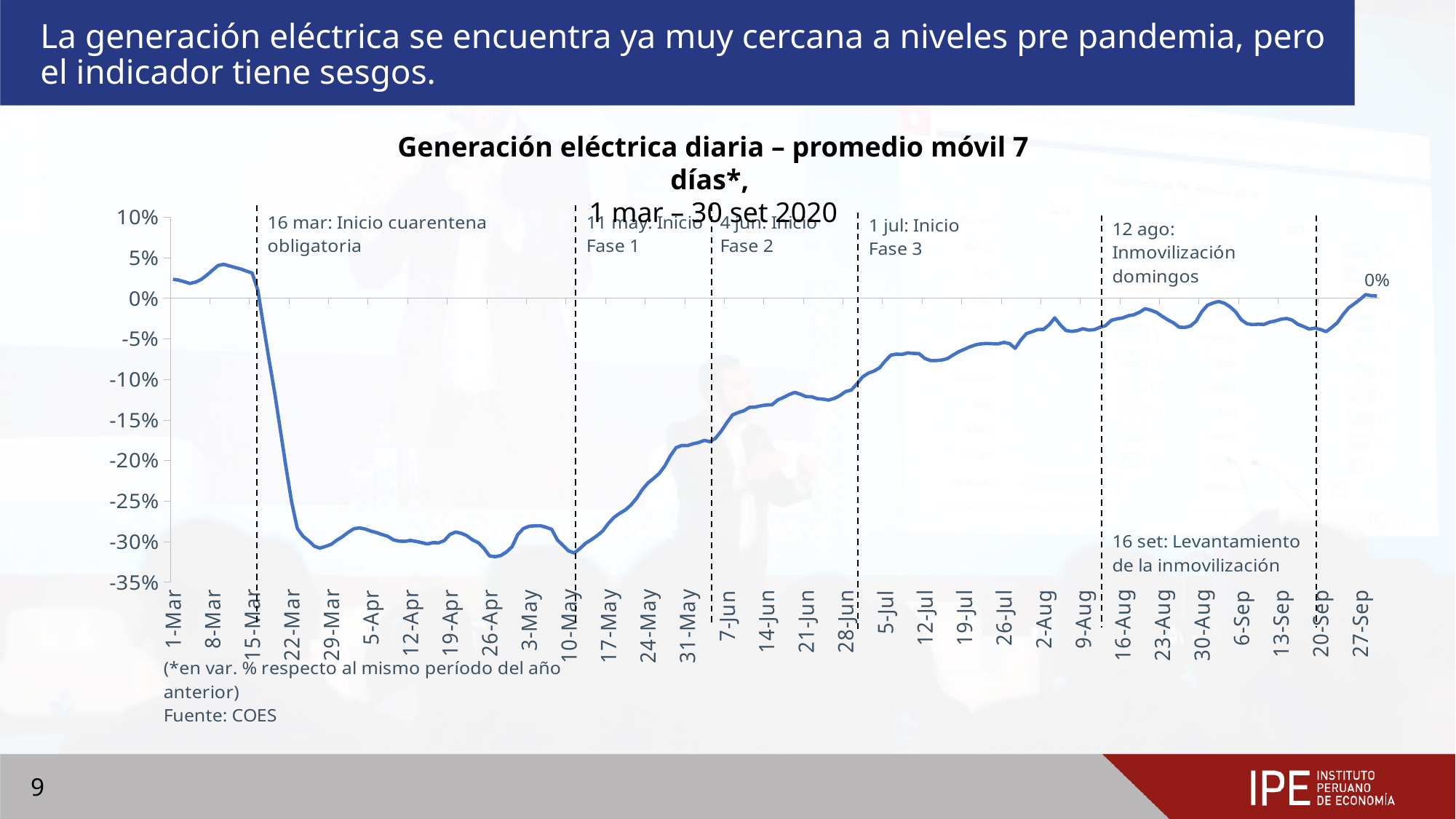
Is the value for 31-May greater or less than -15%? less Is the value for 5-Jul greater or less than -10%? greater Does the line rise or fall between 10-May and 28-Jun? rise Is the value for 26-Apr greater or less than -30%? less What kind of chart is shown on the slide? line chart What event does the annotation at the first dashed vertical line (16 mar) describe? Inicio cuarentena obligatoria What is the source cited below the chart? COES Does the line rise or fall between 15-Mar and 22-Mar? fall What value is printed as the data label at the end of the line (27-Sep)? 0% Which is larger, the value for 1-Mar or the value for 26-Apr? 1-Mar